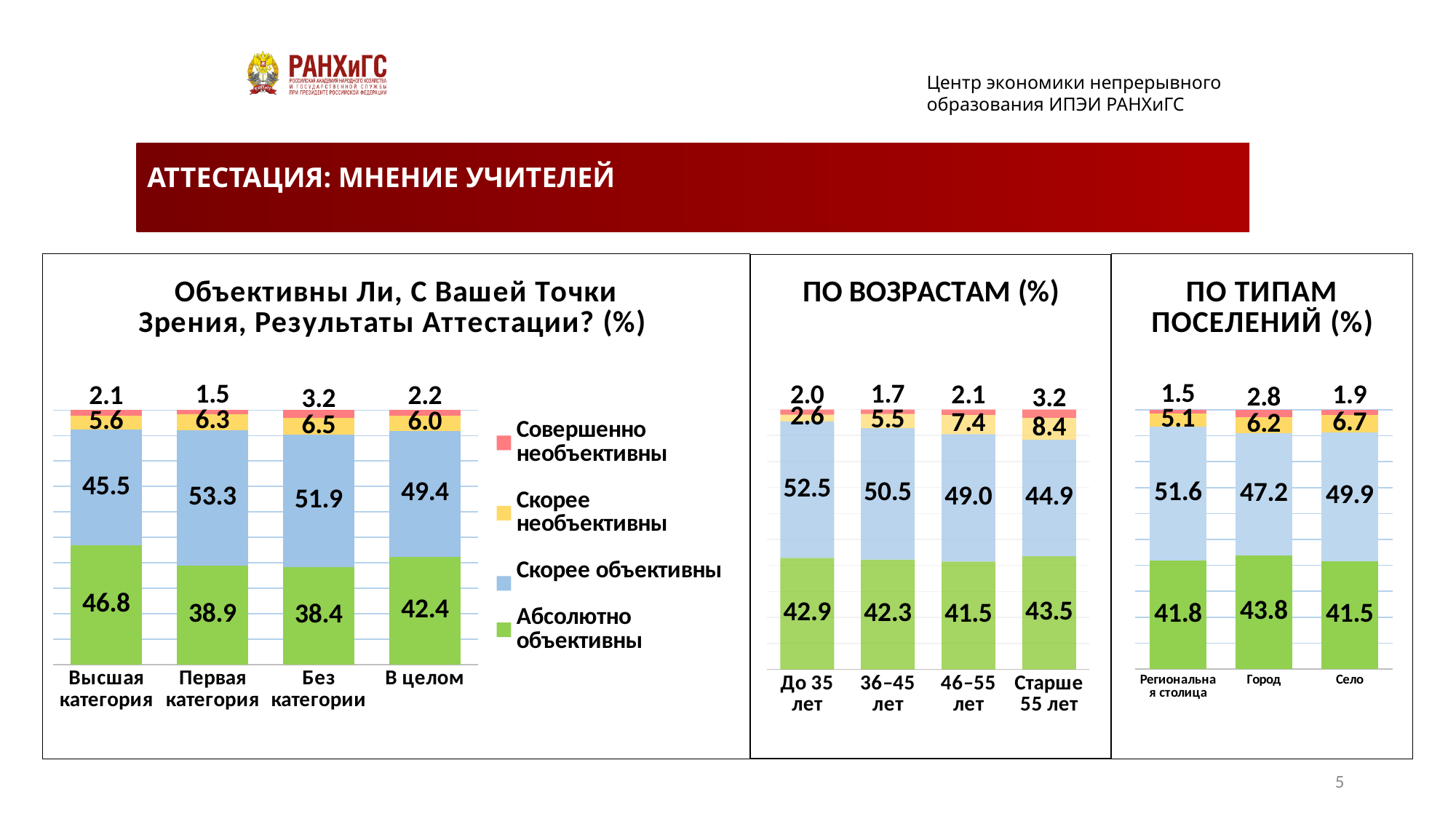
In the chart 'Объективны ли, с Вашей точки зрения, результаты аттестации? (%)', what is the difference between 'Абсолютно объективны' for 'Высшая категория' and for 'Без категории'? 8.4 In the chart 'Объективны ли, с Вашей точки зрения, результаты аттестации? (%)', which category has the highest value for 'Скорее объективны'? Первая категория In the chart 'Объективны ли, с Вашей точки зрения, результаты аттестации? (%)', what is the value of 'Абсолютно объективны' for 'Высшая категория'? 46.8 In the chart 'Объективны ли, с Вашей точки зрения, результаты аттестации? (%)', what is the total of the stacked bar for 'В целом'? 100.0 In the chart 'Объективны ли, с Вашей точки зрения, результаты аттестации? (%)', how many series does the legend list? 4 In the chart 'По возрастам (%)', what is the value of 'Скорее необъективны' for 'Старше 55 лет'? 8.4 In the chart 'По возрастам (%)', does the 'Скорее объективны' value rise or fall from 'До 35 лет' to 'Старше 55 лет'? fall In the chart 'По типам поселений (%)', which is larger: 'Скорее объективны' for 'Региональная столица' or for 'Село'? Региональная столица In the chart 'По возрастам (%)', which age group has the lowest value for 'Скорее объективны'? Старше 55 лет What kind of chart is 'По типам поселений (%)'? stacked bar chart In the chart 'По возрастам (%)', how many age groups are shown? 4 In the chart 'По типам поселений (%)', what is the value of 'Абсолютно объективны' for 'Город'? 43.8